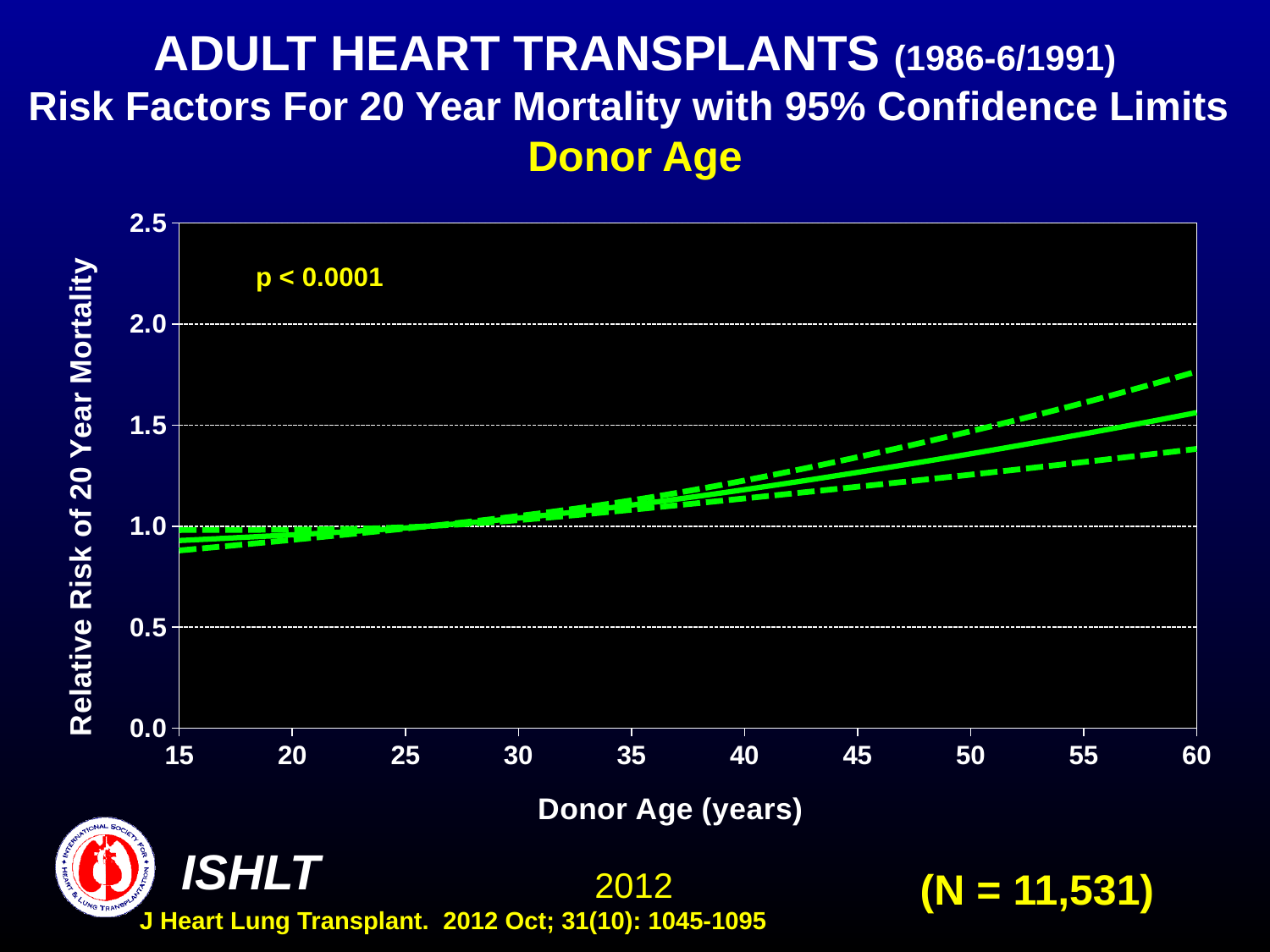
Is the relative risk shown by the solid line at a donor age of 40 years greater or less than 1.0? greater Is the lower confidence limit (lower dashed line) at a donor age of 60 years greater or less than 1.5? less What is the p-value printed on the chart? p < 0.0001 What kind of chart is shown on the slide? line chart Is the upper confidence limit (upper dashed line) at a donor age of 60 years greater or less than 1.5? greater What is the maximum value shown on the y axis? 2.5 Does the relative risk of 20 year mortality rise or fall as donor age increases? rise What is the label of the x axis? Donor Age (years) What is the sample size (N) printed on the slide? N = 11,531 How many lines are plotted on the chart? 3